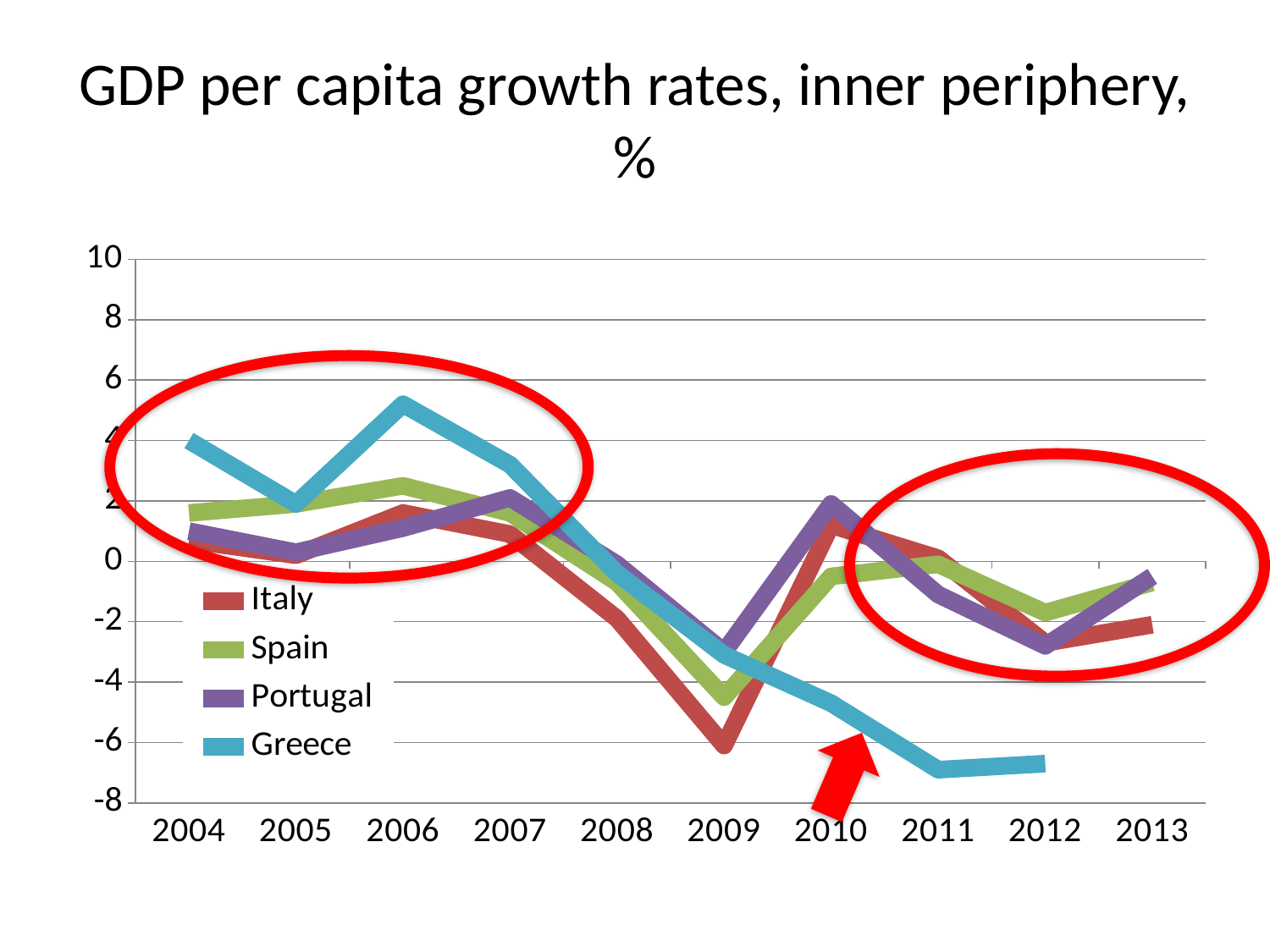
Which country had the lowest GDP per capita growth rate in 2012? Greece How many series does the legend list? 4 Which country had the highest GDP per capita growth rate in 2006? Greece How many years are shown on the x axis? 10 Is the value for Greece in 2006 greater or less than 4? greater Is the value for Greece in 2011 greater or less than -6? less Does the Greece line rise or fall from 2006 to 2011? fall Which country had the highest GDP per capita growth rate in 2010? Portugal What is the title of the chart? GDP per capita growth rates, inner periphery, % What kind of chart is shown on the slide? line chart Which country had the lowest GDP per capita growth rate in 2009? Italy Which country is represented by the blue line? Greece